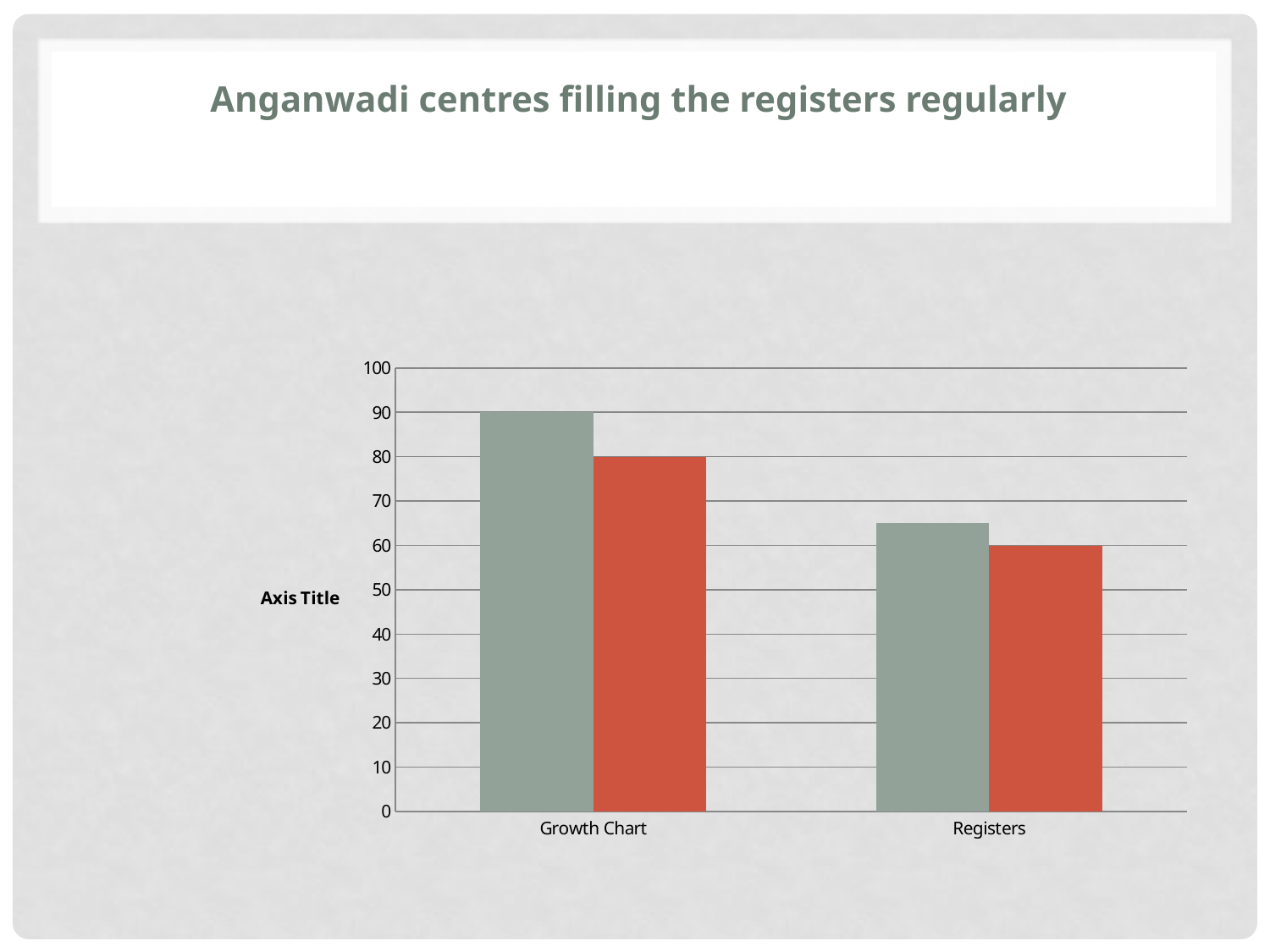
Which category has the tallest bar? Growth Chart What is the value of the grey bar for Growth Chart? 90 What is the difference between the red bar for Growth Chart and the red bar for Registers? 20 What is the value of the red bar for Growth Chart? 80 What is the title of the slide? Anganwadi centres filling the registers regularly What kind of chart is shown on the slide? bar chart Is the value of the grey bar for Registers greater or less than 60? greater Which is larger: the grey bar for Growth Chart or the grey bar for Registers? Growth Chart What is the difference between the grey bar and the red bar for Growth Chart? 10 How many categories are shown on the x axis? 2 Is the value of the grey bar for Registers greater or less than 70? less What is the value of the red bar for Registers? 60